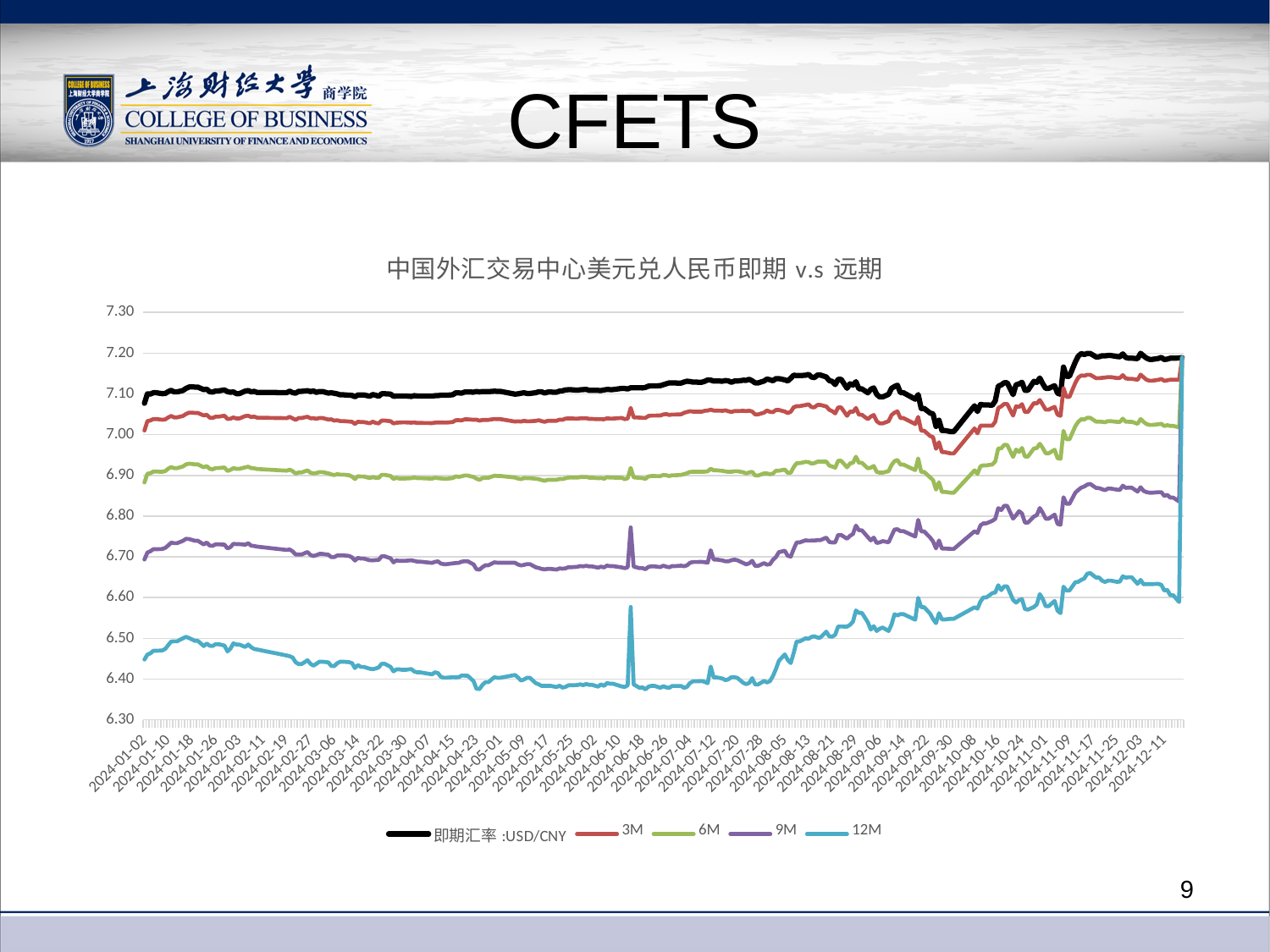
What kind of chart is shown on the slide? line chart What is the title of the chart? 中国外汇交易中心美元兑人民币即期 v.s 远期 At 2024-08-13, which is larger: the 即期汇率:USD/CNY series or the 12M series? 即期汇率:USD/CNY Is the value of the 即期汇率:USD/CNY series at 2024-09-30 greater or less than 7.10? less Is the value of the 9M series at 2024-11-17 greater or less than 6.80? greater Which series lies lowest on the chart across the whole period? 12M Does the 即期汇率:USD/CNY series rise or fall between 2024-08-13 and 2024-09-30? fall Which series lies highest on the chart across the whole period? 即期汇率:USD/CNY Is the value of the 12M series at 2024-01-02 greater or less than 6.50? less How many series does the legend list? 5 Which series is drawn with the black line? 即期汇率:USD/CNY